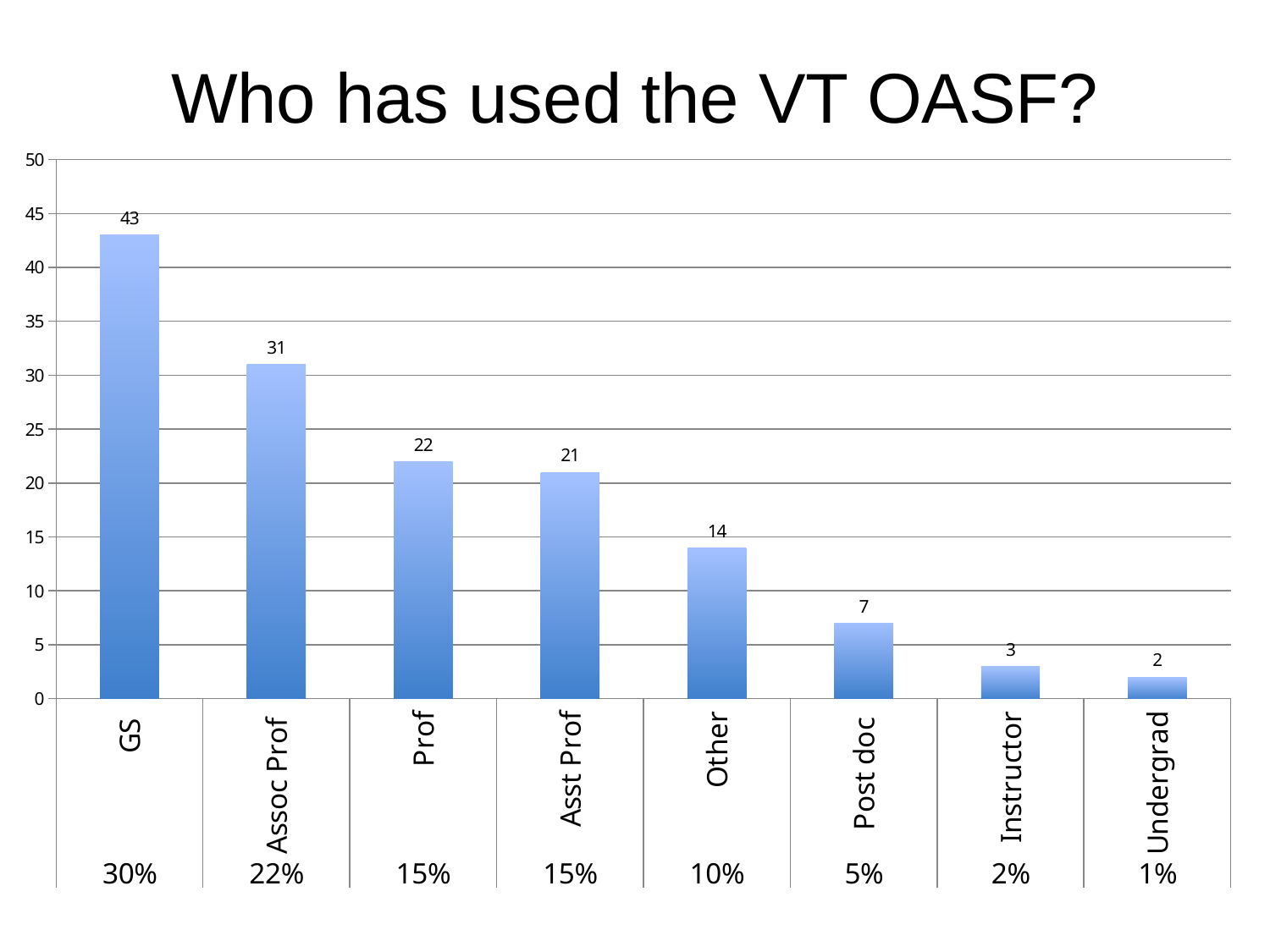
Which category has the lowest value? Undergrad What percentage is shown below the Assoc Prof bar? 22% What kind of chart is shown on the slide? bar chart Which is larger, the value for Other or the value for Post doc? Other What is the value for GS? 43 What is the value for Post doc? 7 Is the value for Asst Prof greater or less than 25? less Do the values rise or fall from left to right along the x axis? fall What is the difference between the values for GS and Assoc Prof? 12 What is the title of the chart? Who has used the VT OASF? Which category has the highest value? GS How many categories are shown on the x axis? 8